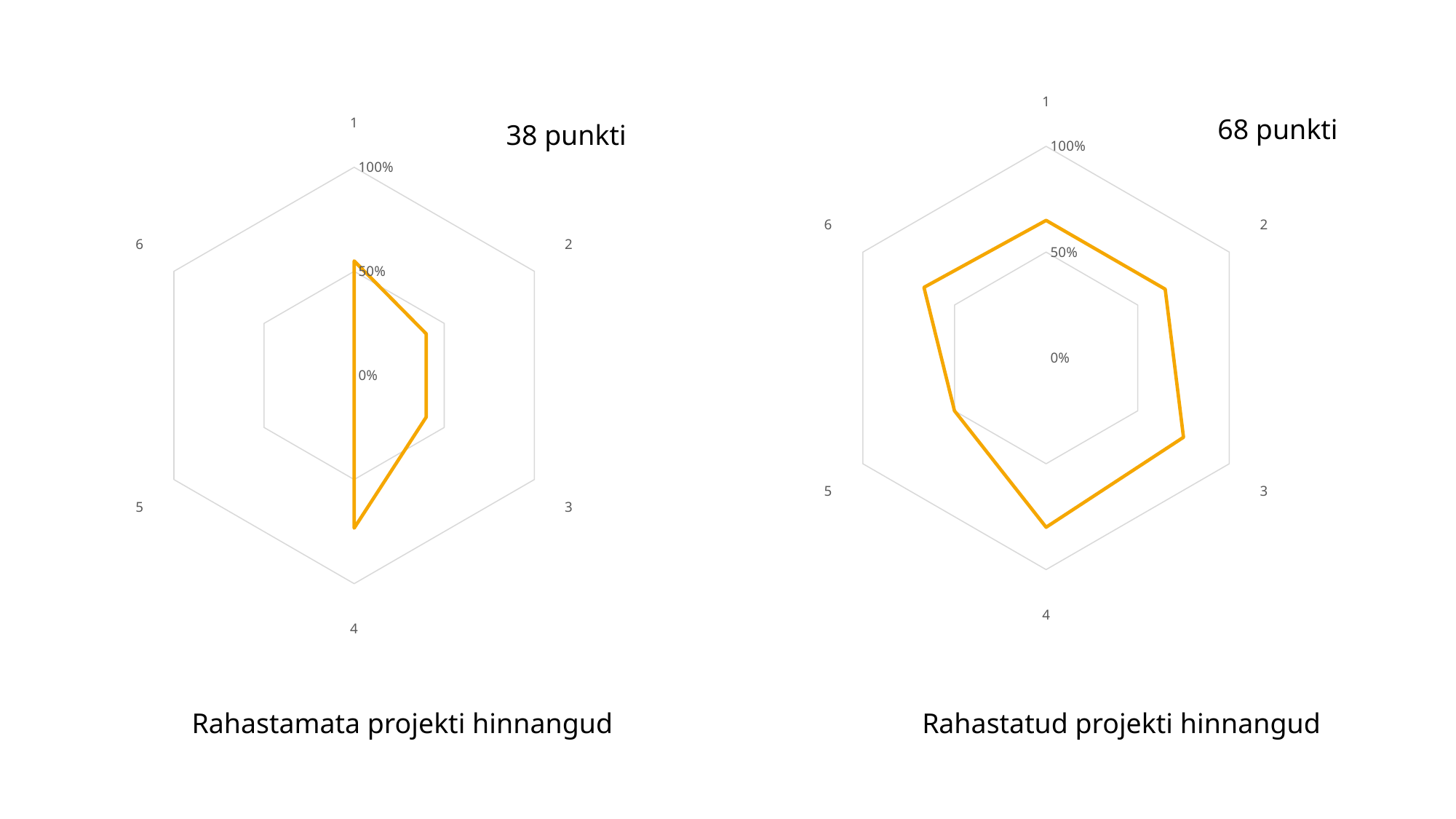
In the 'Rahastatud projekti hinnangud' chart on the right, which is larger: the value for category 4 or the value for category 5? category 4 In the 'Rahastamata projekti hinnangud' chart on the left, which category has the highest value? 4 In the 'Rahastamata projekti hinnangud' chart on the left, which is larger: the value for category 1 or the value for category 5? category 1 What point total is shown above the 'Rahastatud projekti hinnangud' chart on the right? 68 punkti In the 'Rahastamata projekti hinnangud' chart on the left, is the value for category 2 greater or less than 50%? less How many axes (categories) does the 'Rahastatud projekti hinnangud' chart on the right have? 6 In the 'Rahastatud projekti hinnangud' chart on the right, is the value for category 1 greater or less than 50%? greater In the 'Rahastatud projekti hinnangud' chart on the right, which category has the lowest value? 5 What point total is shown above the 'Rahastamata projekti hinnangud' chart on the left? 38 punkti In the 'Rahastatud projekti hinnangud' chart on the right, which category has the highest value? 4 In the 'Rahastamata projekti hinnangud' chart on the left, is the value for category 4 greater or less than 50%? greater What kind of chart is the 'Rahastamata projekti hinnangud' chart on the left? radar chart